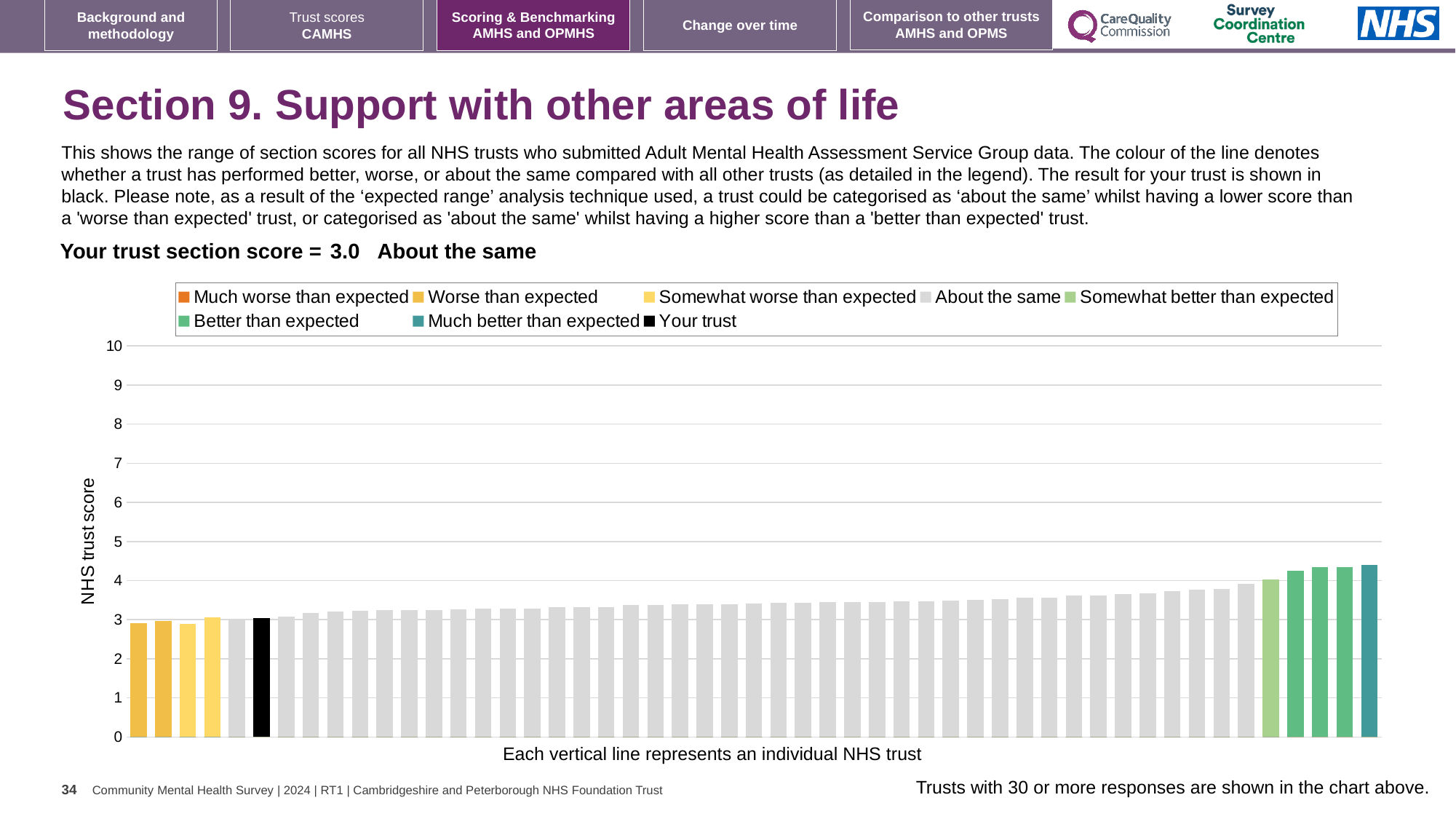
Which category does your trust fall into according to the slide? About the same Which legend category does the tallest bar in the chart belong to? Much better than expected Is the value of the tallest bar in the chart greater or less than 5? less How many entries does the chart legend list? 8 How many bars are coloured as 'Better than expected' (green)? 3 What kind of chart is shown on the slide? bar chart What colour is used for 'Your trust' in the legend? black Is the value of the black 'Your trust' bar greater or less than 5? less Is the value of the shortest bar in the chart greater or less than 2? greater What is the section score for your trust shown on the slide? 3.0 Do the bar values rise or fall from left to right along the x axis? rise What is the label on the vertical axis of the chart? NHS trust score